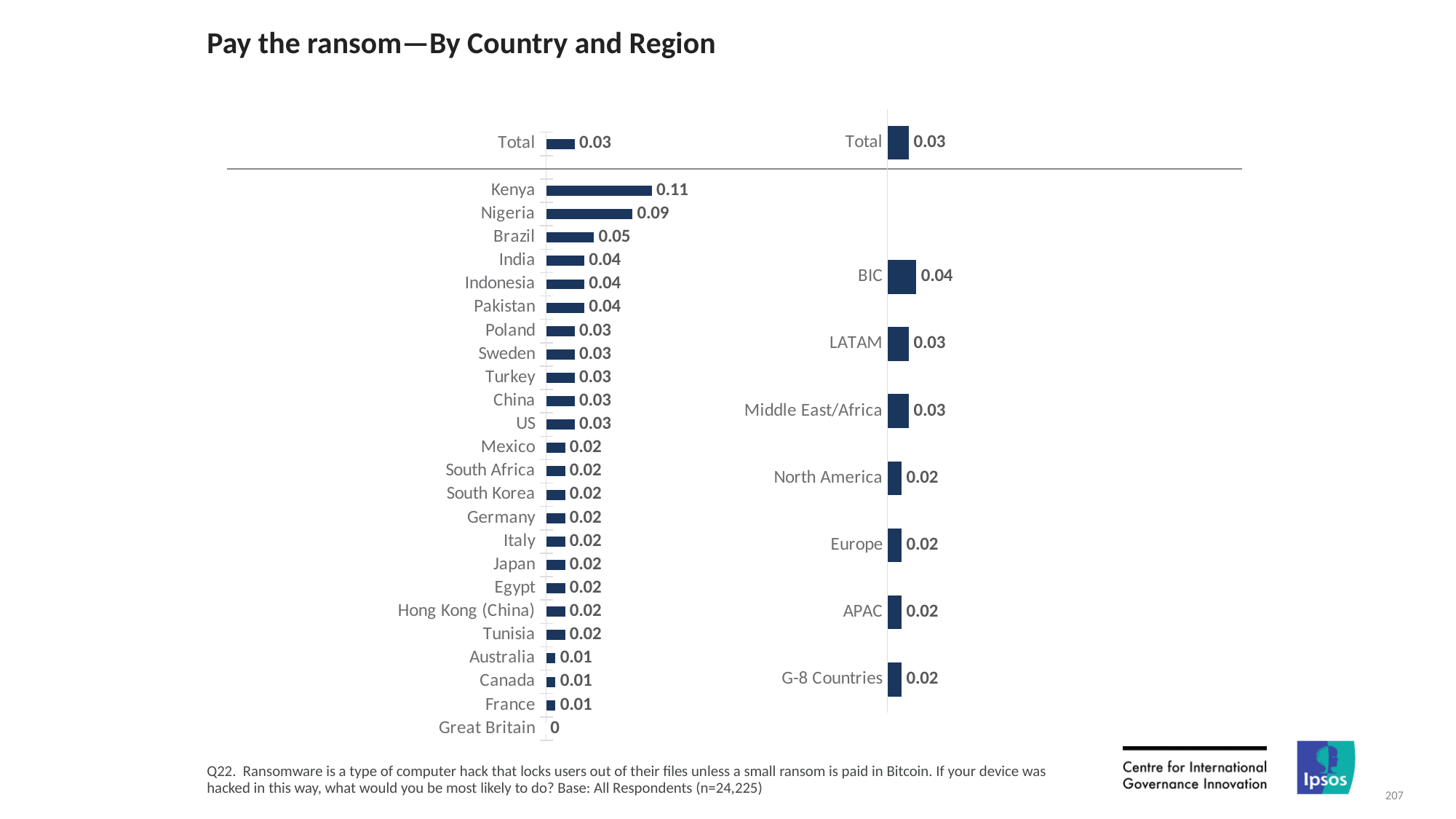
In the right chart (by region), which region has the highest value? BIC What kind of chart is the left chart (by country)? Bar chart In the right chart (by region), what is the value for BIC? 0.04 In the left chart (by country), which country has the highest value? Kenya In the left chart (by country), what is the difference between the values for Kenya and Nigeria? 0.02 In the left chart (by country), what is the value for Brazil? 0.05 In the right chart (by region), how many regions are listed below the Total bar? 7 In the left chart (by country), what is the value for Kenya? 0.11 In the right chart (by region), what is the difference between the values for BIC and North America? 0.02 In the left chart (by country), which country has the lowest value? Great Britain In the left chart (by country), which is larger, the value for Nigeria or the value for Brazil? Nigeria In the left chart (by country), how many countries are listed below the Total bar? 24